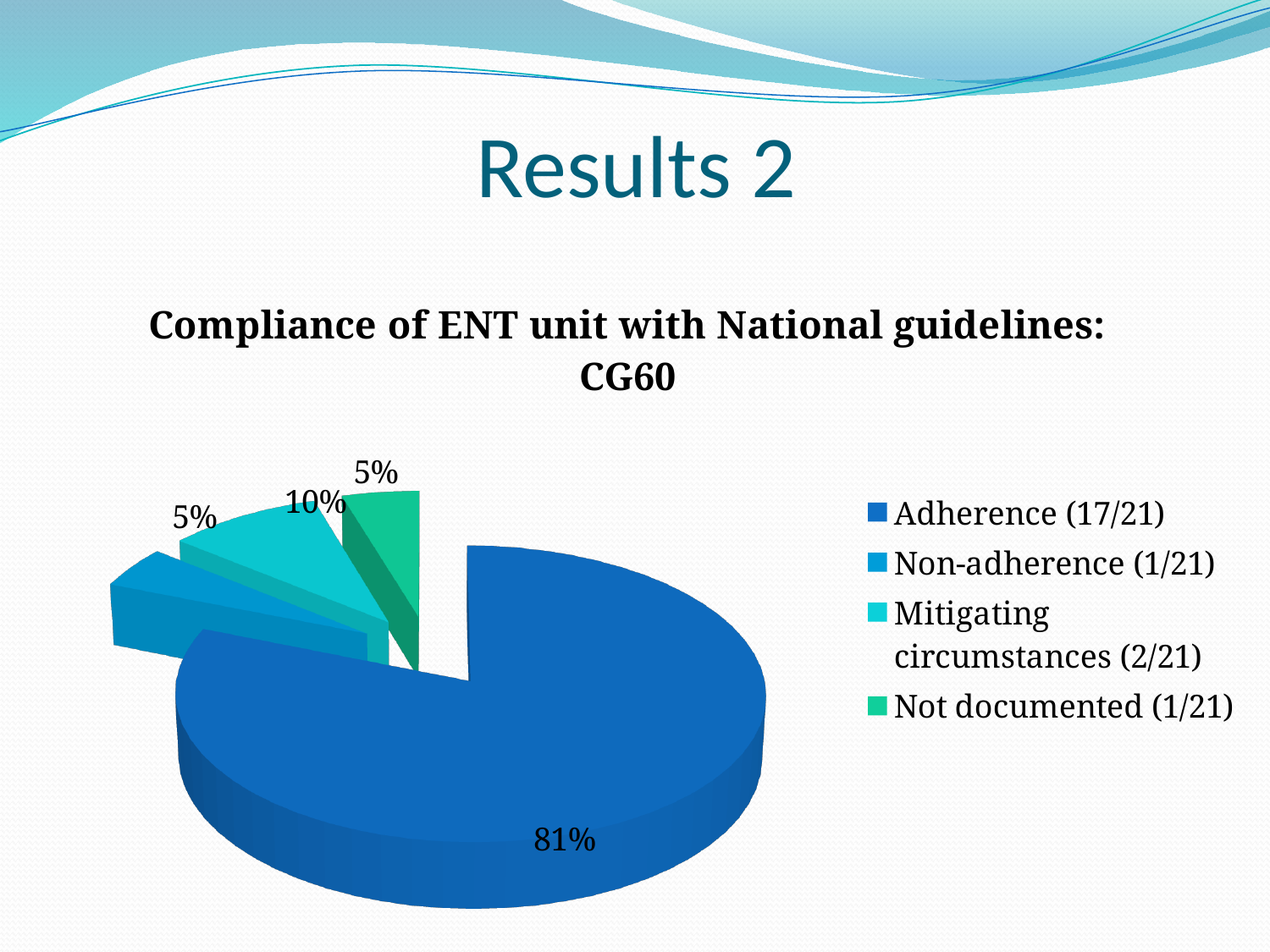
What percentage is shown for Non-adherence (1/21)? 5% What kind of chart is shown on the slide? Pie chart Which is larger, the share for Mitigating circumstances or the share for Non-adherence? Mitigating circumstances What percentage of the pie is labelled for Adherence (17/21)? 81% Which two categories share the smallest slice size of 5%? Non-adherence (1/21) and Not documented (1/21) What share of the pie does the Adherence slice represent? 81% What is the difference in percentage points between the Adherence share and the Mitigating circumstances share? 71 percentage points Which category has the largest share of the pie? Adherence (17/21) What percentage is shown for Not documented (1/21)? 5% What percentage is shown for Mitigating circumstances (2/21)? 10% How many categories does the pie chart have? 4 What is the title of the chart? Compliance of ENT unit with National guidelines: CG60